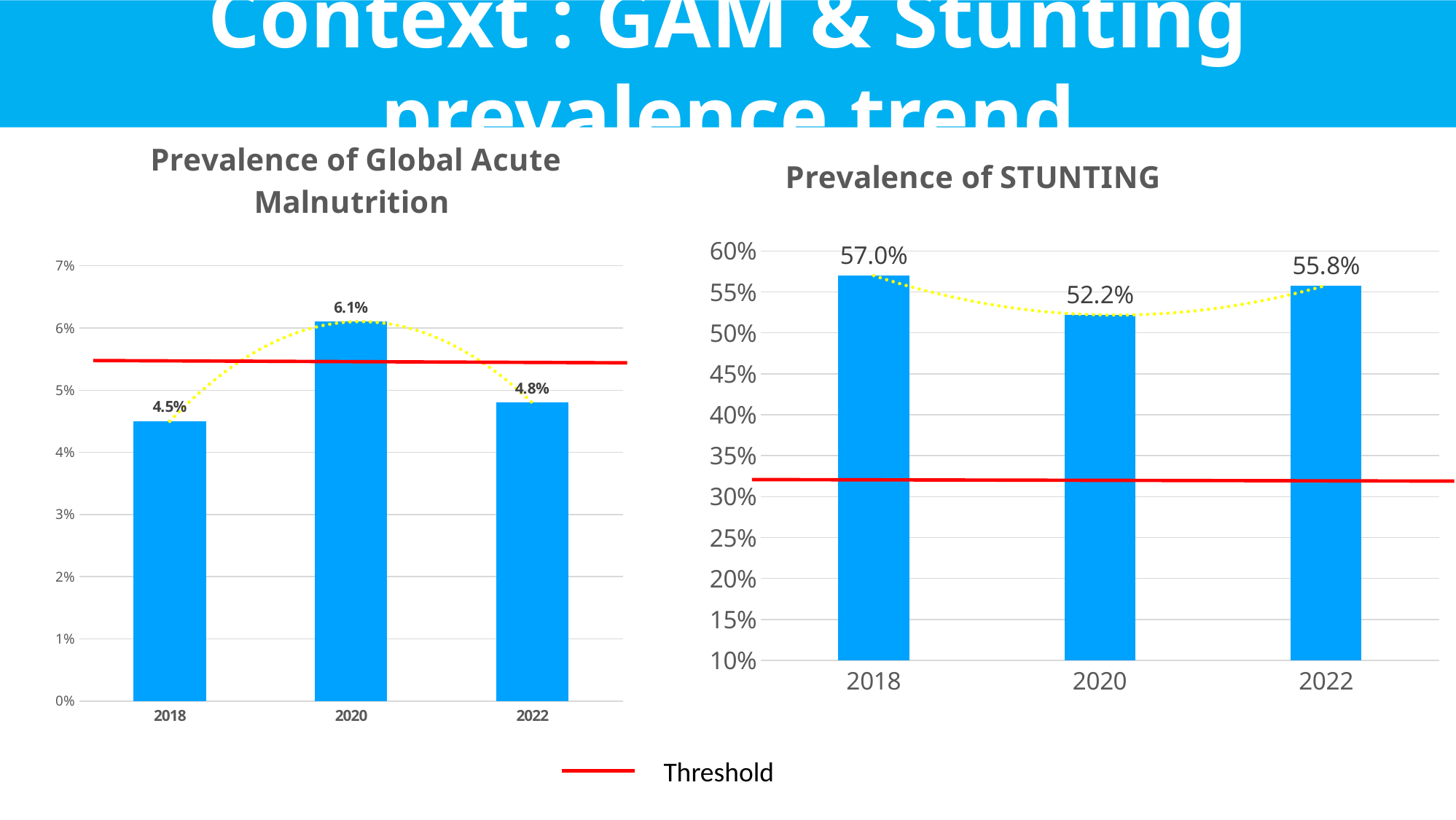
In the 'Prevalence of Global Acute Malnutrition' chart, which year has the highest value? 2020 In the 'Prevalence of STUNTING' chart, what is the difference between the 2018 and 2020 values? 4.8% In the 'Prevalence of Global Acute Malnutrition' chart, what is the value for 2018? 4.5% In the 'Prevalence of Global Acute Malnutrition' chart, what is the difference between the 2020 and 2022 values? 1.3% In the 'Prevalence of STUNTING' chart, which is larger, the value for 2018 or the value for 2022? 2018 How many years are shown on the x axis of the 'Prevalence of STUNTING' chart? 3 In the 'Prevalence of STUNTING' chart, which year has the lowest value? 2020 In the 'Prevalence of Global Acute Malnutrition' chart, is the value for 2022 greater or less than 5%? less What does the red line in the legend at the bottom of the slide represent? Threshold In the 'Prevalence of Global Acute Malnutrition' chart, what is the value for 2020? 6.1% What kind of chart is the 'Prevalence of Global Acute Malnutrition' chart? bar chart In the 'Prevalence of STUNTING' chart, what is the value for 2022? 55.8%